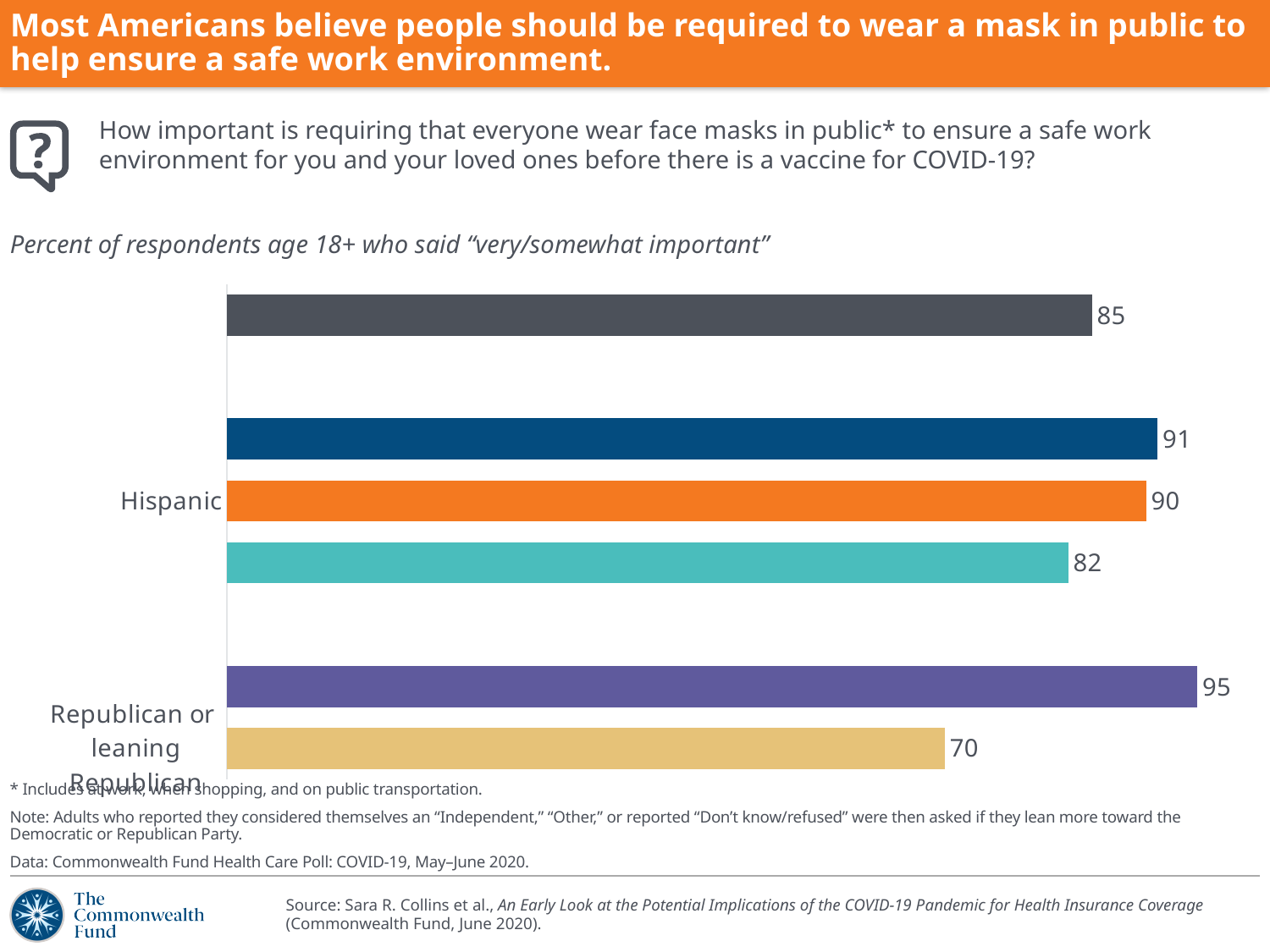
What value is shown for respondents who are Republican or leaning Republican? 70 What is the lowest value shown on any bar in the chart? 70 How many bars are plotted in the chart? 6 What colour is the bar for Hispanic respondents? Orange Which labeled category has the lowest value on the chart? Republican or leaning Republican What is the highest value shown on any bar in the chart? 95 What percent of Hispanic respondents said requiring face masks in public is very/somewhat important? 90 According to the chart subtitle, what response did the percentages represent? Very/somewhat important Which is larger, the value for Hispanic respondents or the value for Republican or leaning Republican respondents? Hispanic What kind of chart is shown on the slide? Bar chart What is the difference between the value for Hispanic respondents and the value for Republican or leaning Republican respondents? 20